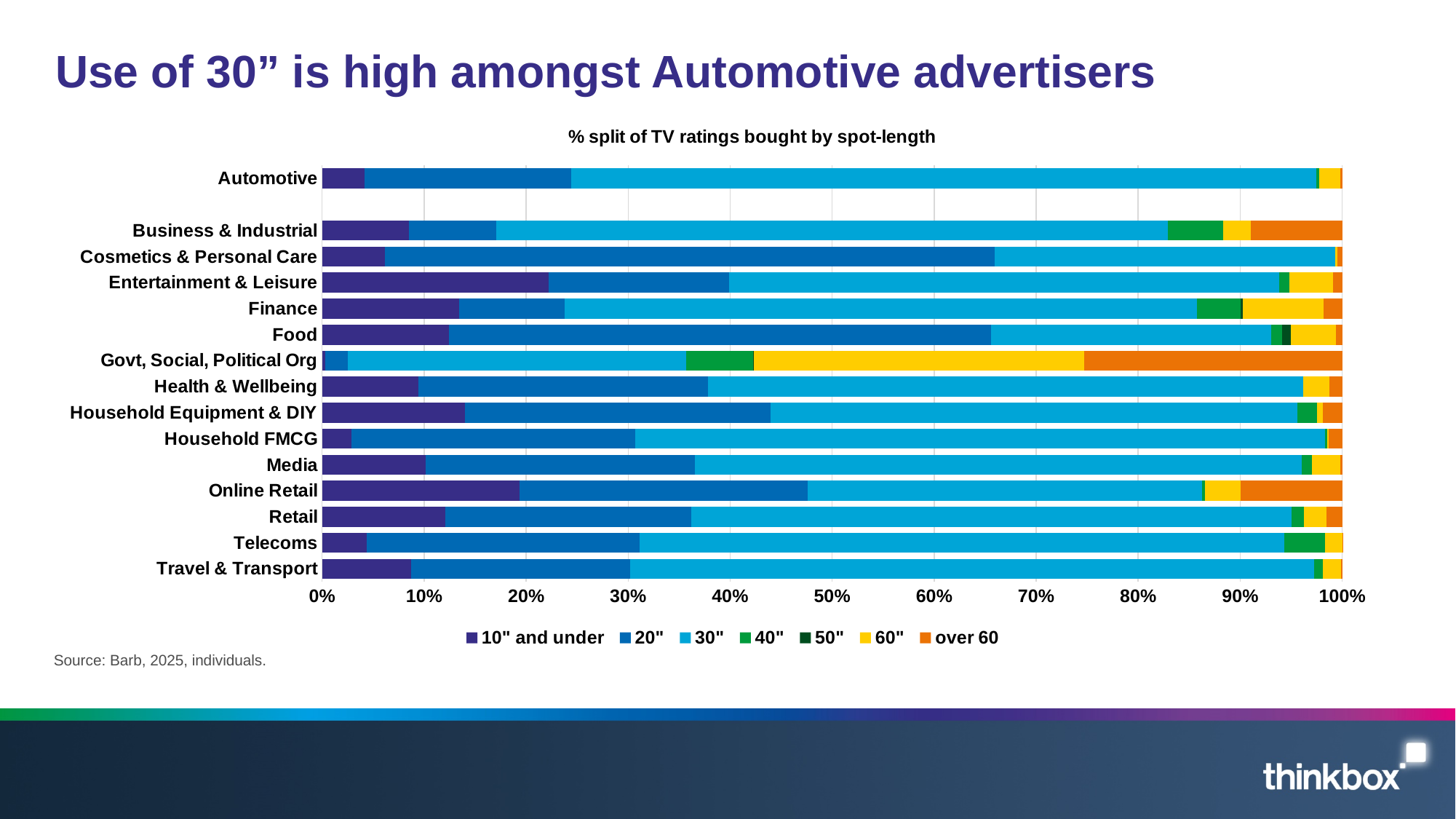
What kind of chart is shown on the slide? Stacked bar chart Which spot-length series is shown in orange in the legend? over 60 Which category has the largest 'over 60' share? Govt, Social, Political Org Which category has the largest 60" share? Govt, Social, Political Org How many advertiser categories are plotted on the chart? 15 What is the title of the chart? % split of TV ratings bought by spot-length Is the 10" and under share for Entertainment & Leisure greater or less than 20%? greater Is the 20" share for Cosmetics & Personal Care greater or less than 50%? greater Which has the larger 10" and under share, Entertainment & Leisure or Automotive? Entertainment & Leisure Is the 10" and under share for Automotive greater or less than 10%? less How many series does the legend list? 7 Which category has the largest 20" share? Cosmetics & Personal Care